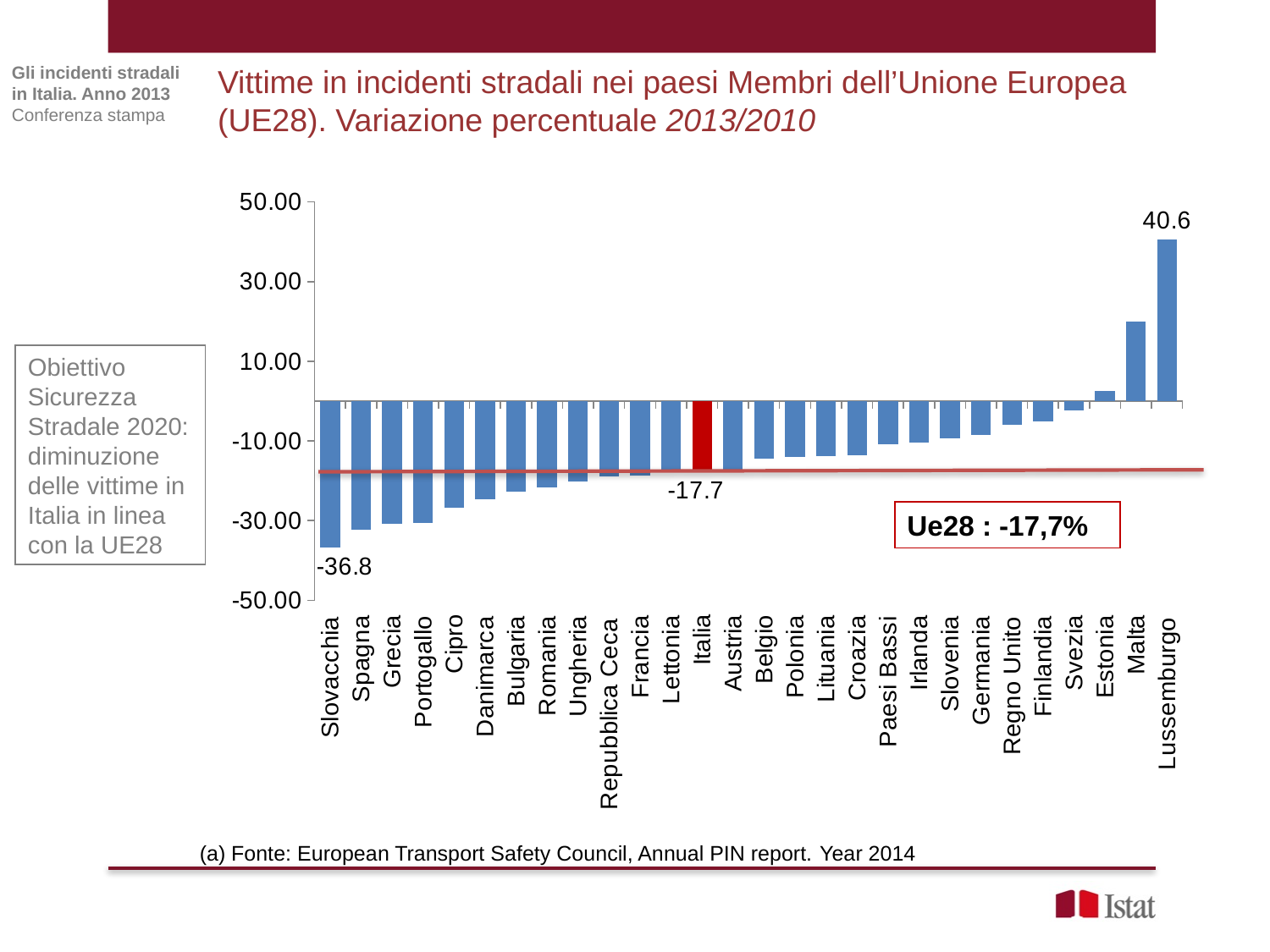
What is the difference between the values for Lussemburgo and Italia? 58.3 What is the value shown for Lussemburgo? 40.6 Is the value for Malta greater or less than 10.00? greater Which country has the highest value in the chart? Lussemburgo How many countries are shown in the chart? 28 What is the value shown for Slovacchia? -36.8 What is the difference between the values for Italia and Slovacchia? 19.1 What kind of chart is shown on the slide? bar chart What is the value shown for Italia? -17.7 Is the value for Spagna greater or less than -30.00? less Which has a larger value, Malta or Spagna? Malta Which country has the lowest value in the chart? Slovacchia